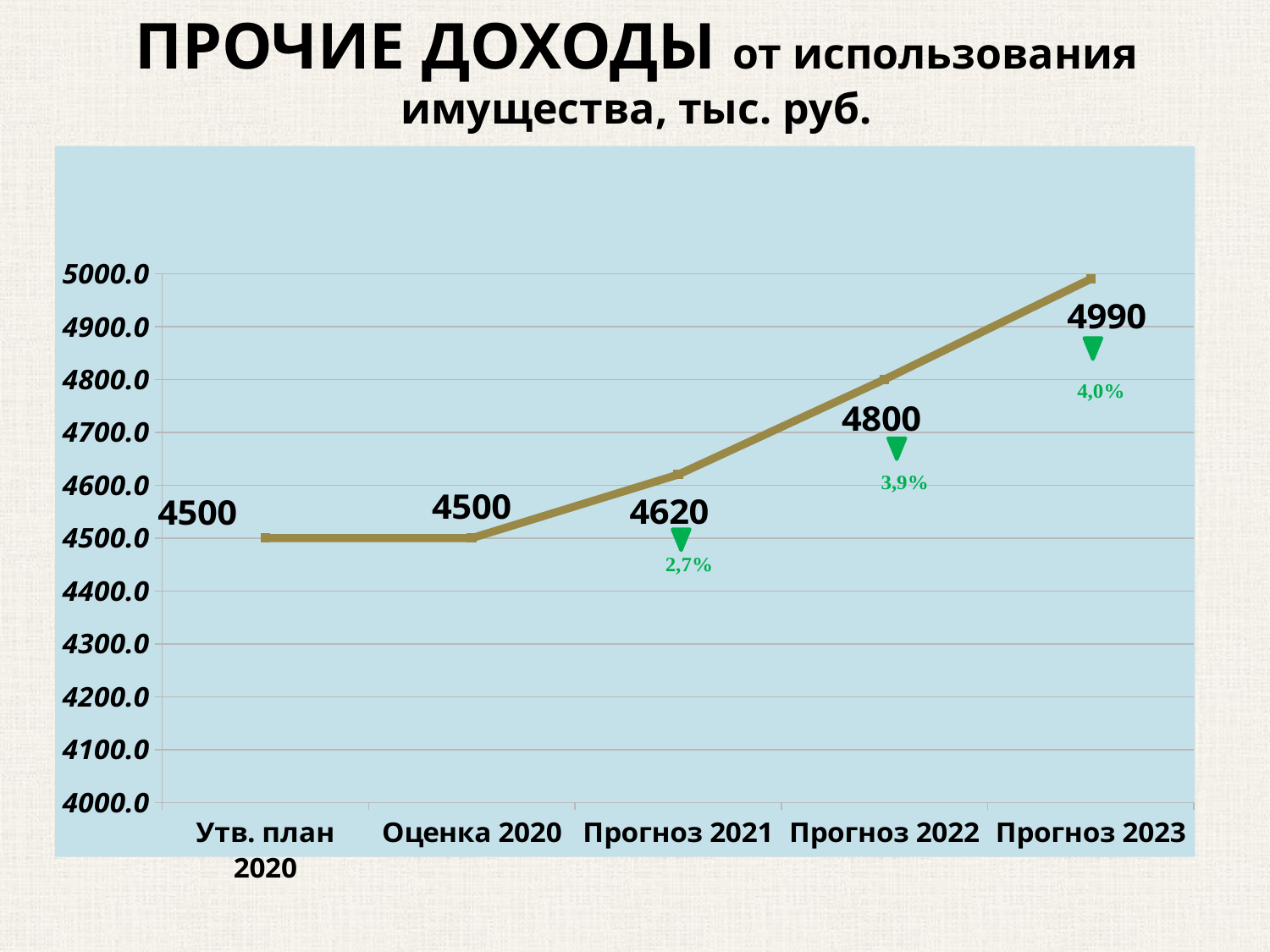
What is the value for Прогноз 2023? 4990 Do the values rise or fall from Оценка 2020 to Прогноз 2023? rise Which is larger, the value for Прогноз 2022 or the value for Прогноз 2021? Прогноз 2022 What is the value for Прогноз 2021? 4620 Is the value for Прогноз 2022 greater or less than 4700? greater What is the value for Прогноз 2022? 4800 Which category has the highest value? Прогноз 2023 What is the difference between the values for Прогноз 2023 and Прогноз 2022? 190 How many categories are shown on the x axis? 5 What is the value for Оценка 2020? 4500 What kind of chart is shown on the slide? line chart What is the difference between the values for Прогноз 2021 and Оценка 2020? 120